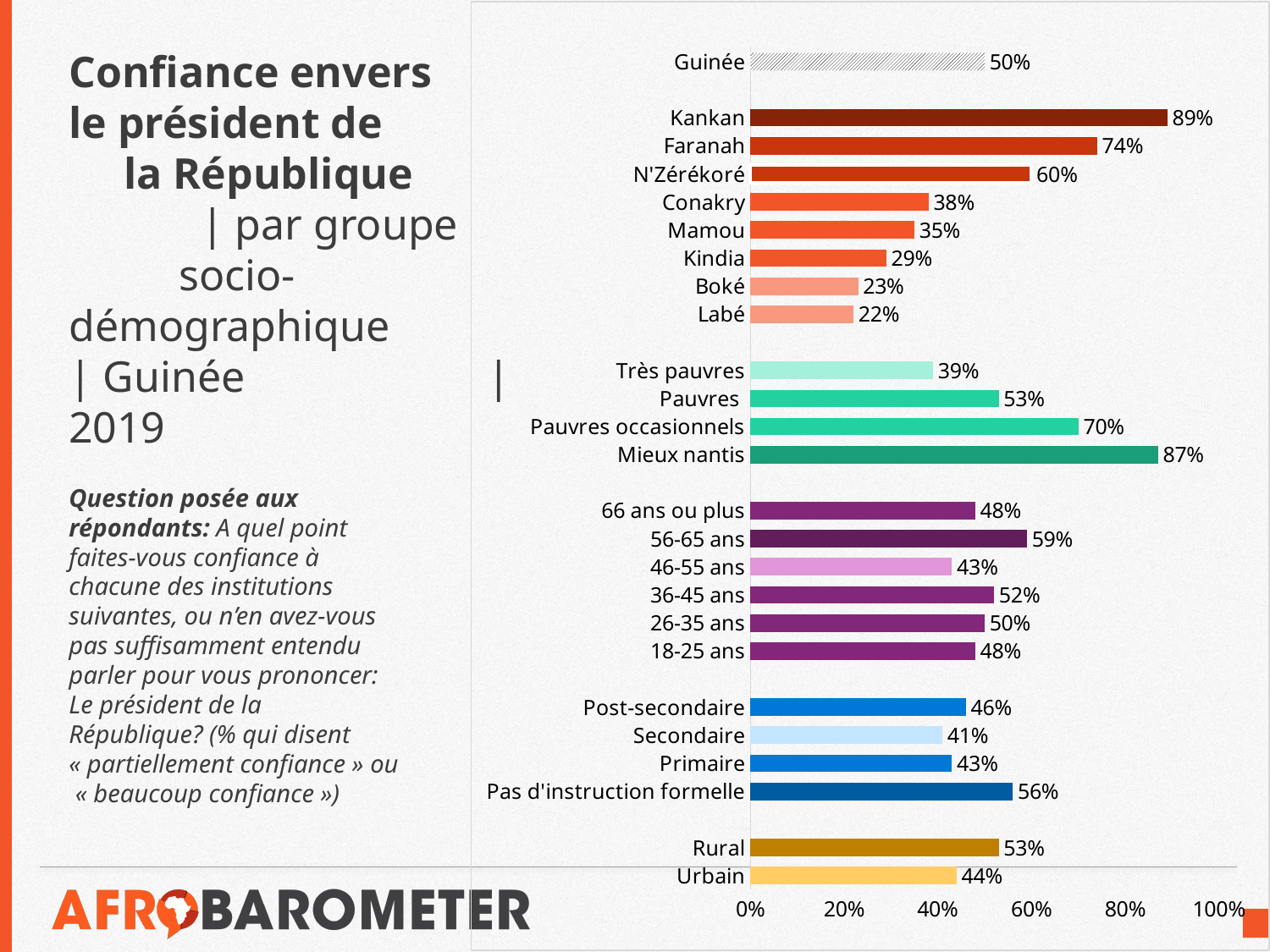
Which category has the lowest value on the chart? Labé What is the difference between the values for Kankan and Labé? 67% How many bars are plotted on the chart? 25 What is the value for Guinée overall? 50% What is the value for Kankan? 89% Which is larger, the value for Faranah or the value for Pauvres occasionnels? Faranah Which category has the highest value on the chart? Kankan What is the difference between the values for Rural and Urbain? 9% What kind of chart is shown on the slide? bar chart What is the value for Mieux nantis? 87% Is the value for Conakry greater or less than 40%? less What is the value for Pas d'instruction formelle? 56%